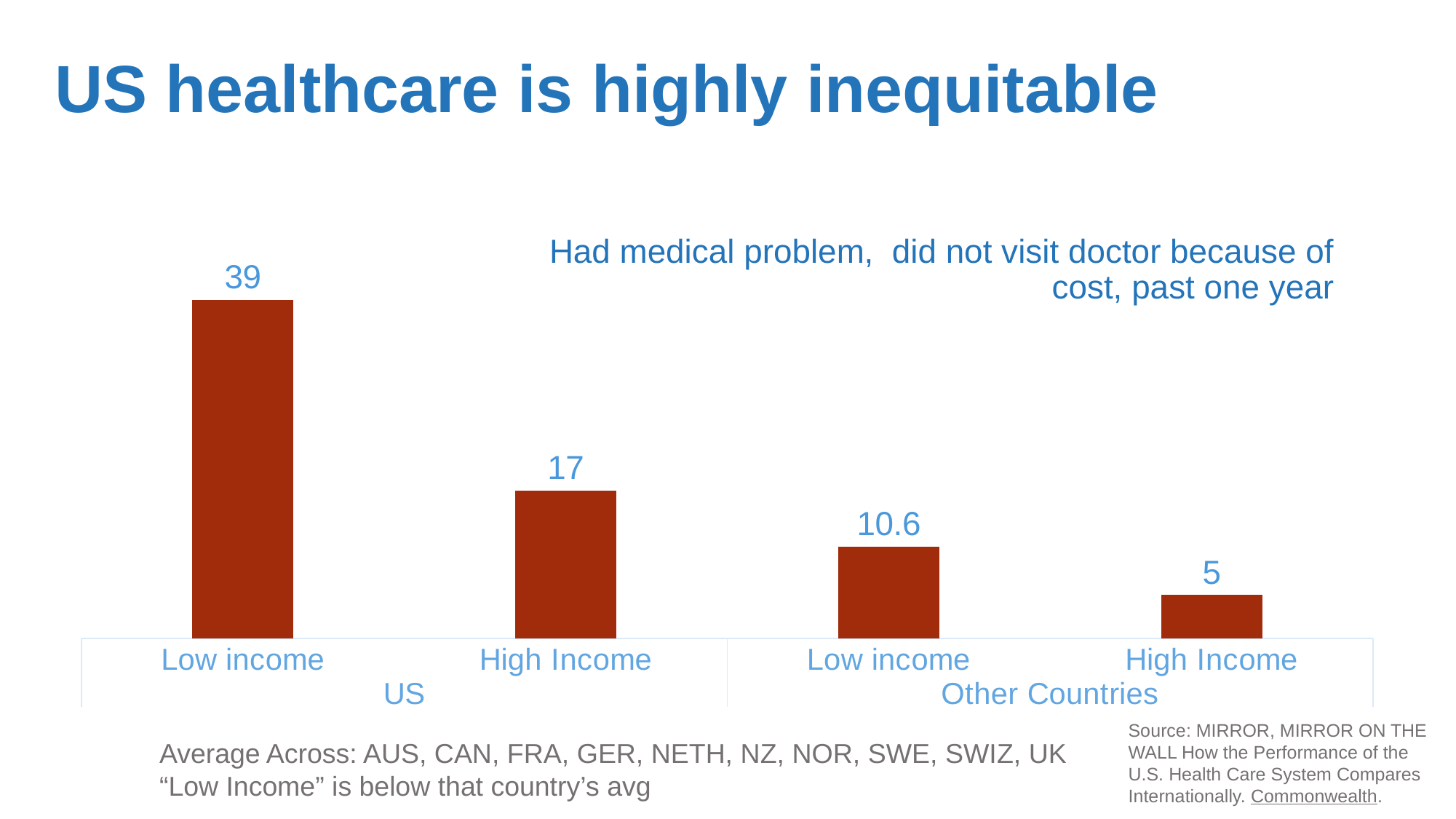
Which bar has the highest value? Low income (US) What is the value for High Income in the US? 17 What is the difference between the US Low income value and the US High Income value? 22 What is the difference between the Low income values for the US and Other Countries? 28.4 What is the value for Low income in the US? 39 What kind of chart is shown on the slide? Bar chart What is the value for Low income in Other Countries? 10.6 What is the value for High Income in Other Countries? 5 Which is larger: the US High Income value or the Other Countries Low income value? US High Income How many bars are plotted in the chart? 4 What is the title of the chart? Had medical problem, did not visit doctor because of cost, past one year Which bar has the lowest value? High Income (Other Countries)